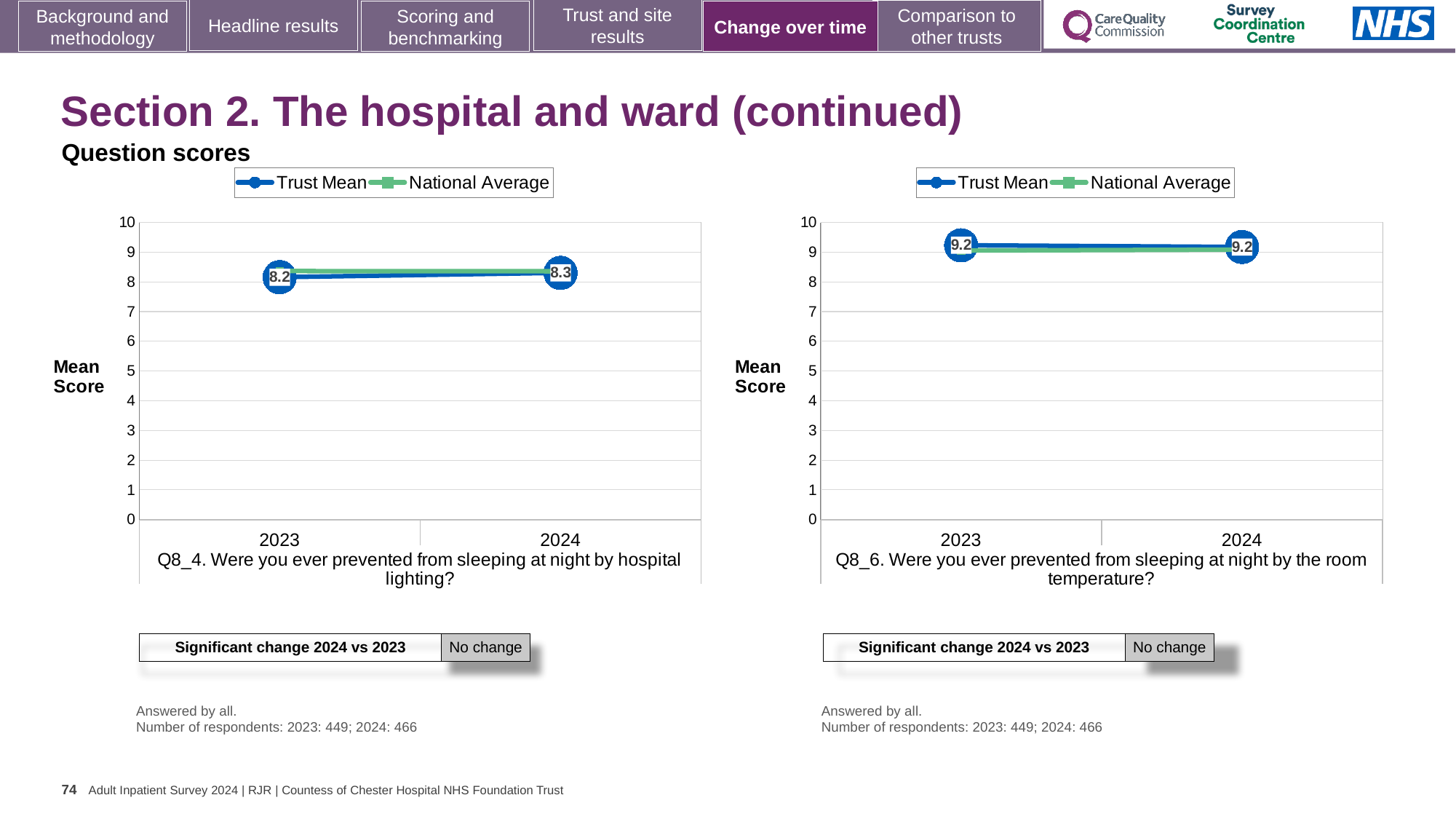
In the Q8_4 chart (left), what is the Trust Mean for 2024? 8.3 In the Q8_6 chart (right), is the Trust Mean for 2024 greater or less than 9? greater In the Q8_4 chart (left), what is the Trust Mean for 2023? 8.2 In the Q8_4 chart (left), is the Trust Mean for 2023 greater or less than 8? greater In the Q8_6 chart (right), what is the Trust Mean for 2023? 9.2 In the Q8_6 chart (right), what is the Trust Mean for 2024? 9.2 How many years are shown on the x axis of the Q8_6 chart (right)? 2 What are the two series named in the legend of the Q8_6 chart (right)? Trust Mean and National Average How many series does the legend of the Q8_4 chart (left) list? 2 In the Q8_4 chart (left), what is the difference between the Trust Mean for 2024 and 2023? 0.1 In the Q8_4 chart (left), does the Trust Mean rise or fall from 2023 to 2024? Rise What kind of chart is the Q8_6 chart (right)? Line chart